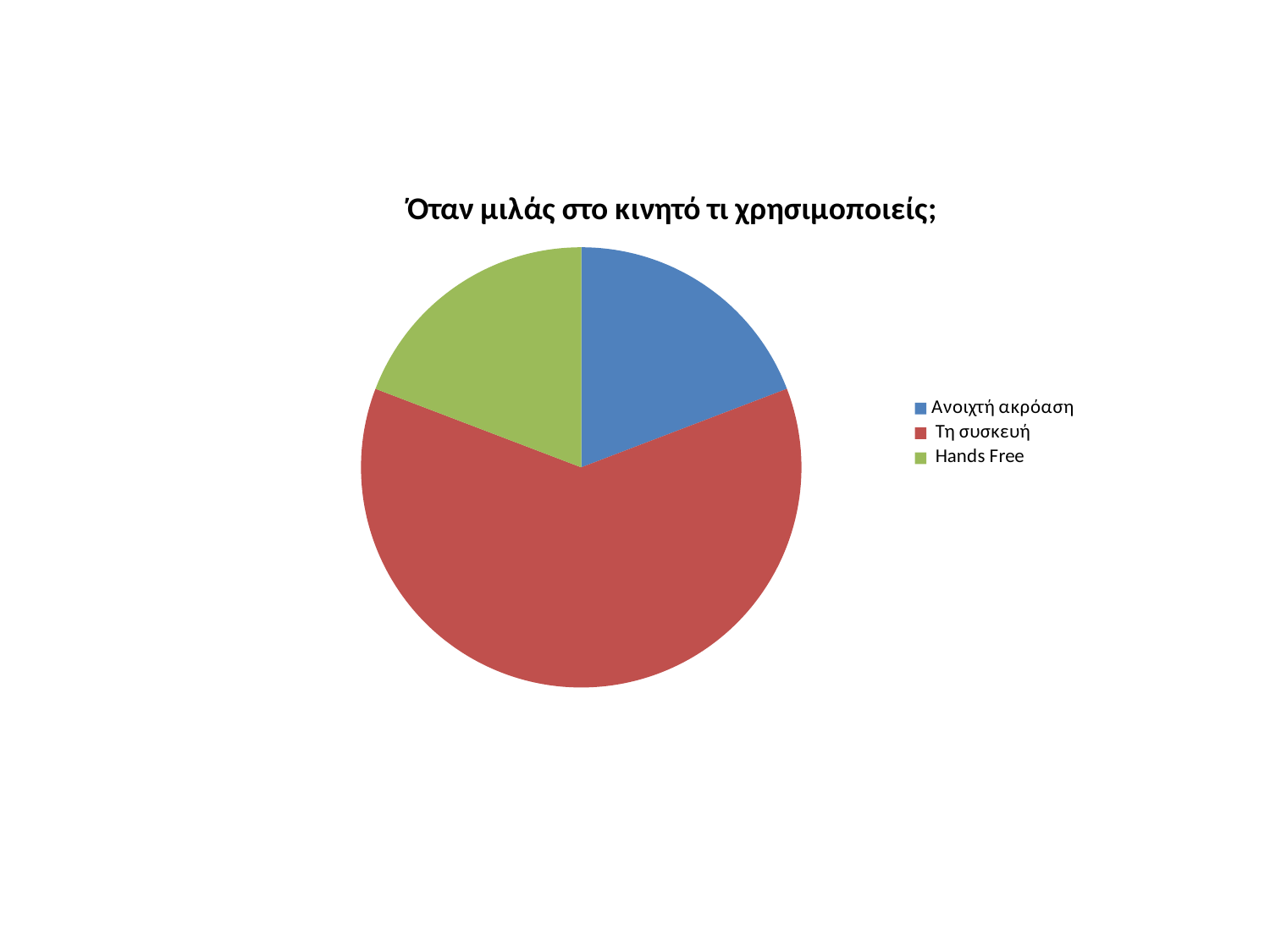
Does the slice for Τη συσκευή take up more or less than half of the pie? more Which category has the largest slice of the pie? Τη συσκευή What is the title of the chart? Όταν μιλάς στο κινητό τι χρησιμοποιείς; What kind of chart is shown on the slide? pie chart How many slices does the pie chart have? 3 Which category is shown in blue? Ανοιχτή ακρόαση Which is larger, the slice for Τη συσκευή or the slice for Ανοιχτή ακρόαση? Τη συσκευή Which is larger, the slice for Hands Free or the slice for Τη συσκευή? Τη συσκευή How many entries does the legend list? 3 What colour is the slice for Hands Free? green